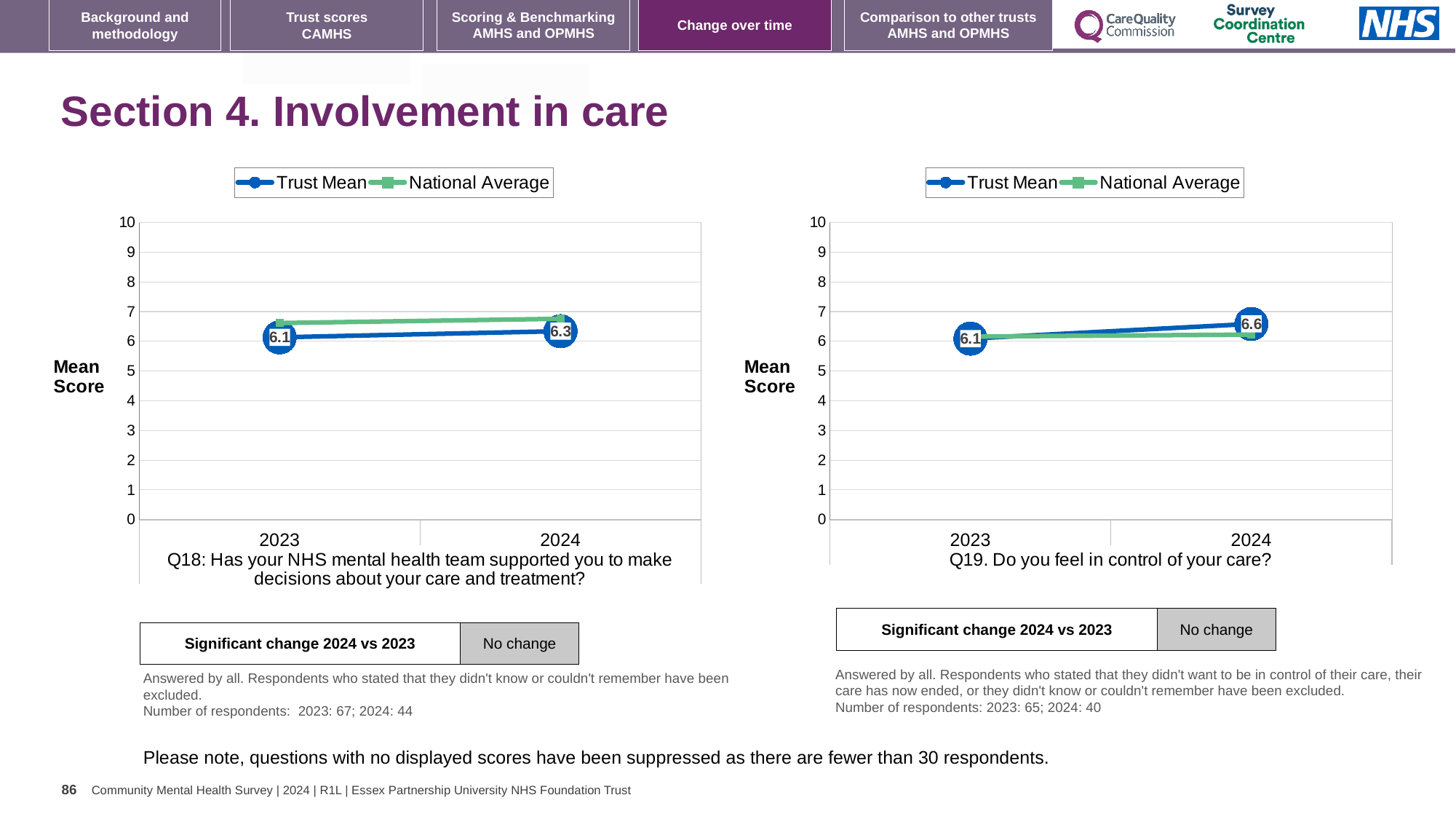
In the Q18 chart, by how much did the Trust Mean change from 2023 to 2024? 0.2 In the Q19 chart for 2024, which is larger, the Trust Mean or the National Average? Trust Mean In the Q19 chart, does the Trust Mean rise or fall from 2023 to 2024? rise In the Q19 chart, what is the Trust Mean score for 2024? 6.6 How many series does the legend of the Q19 chart list? 2 In the Q18 chart, what is the Trust Mean score for 2024? 6.3 In the Q19 chart, what is the Trust Mean score for 2023? 6.1 How many years are shown on the x axis of the Q18 chart? 2 In the Q18 chart, what is the Trust Mean score for 2023? 6.1 In the Q19 chart, by how much did the Trust Mean change from 2023 to 2024? 0.5 In the Q18 chart, is the National Average for 2024 greater or less than 6? greater What kind of chart is the Q18 chart? line chart